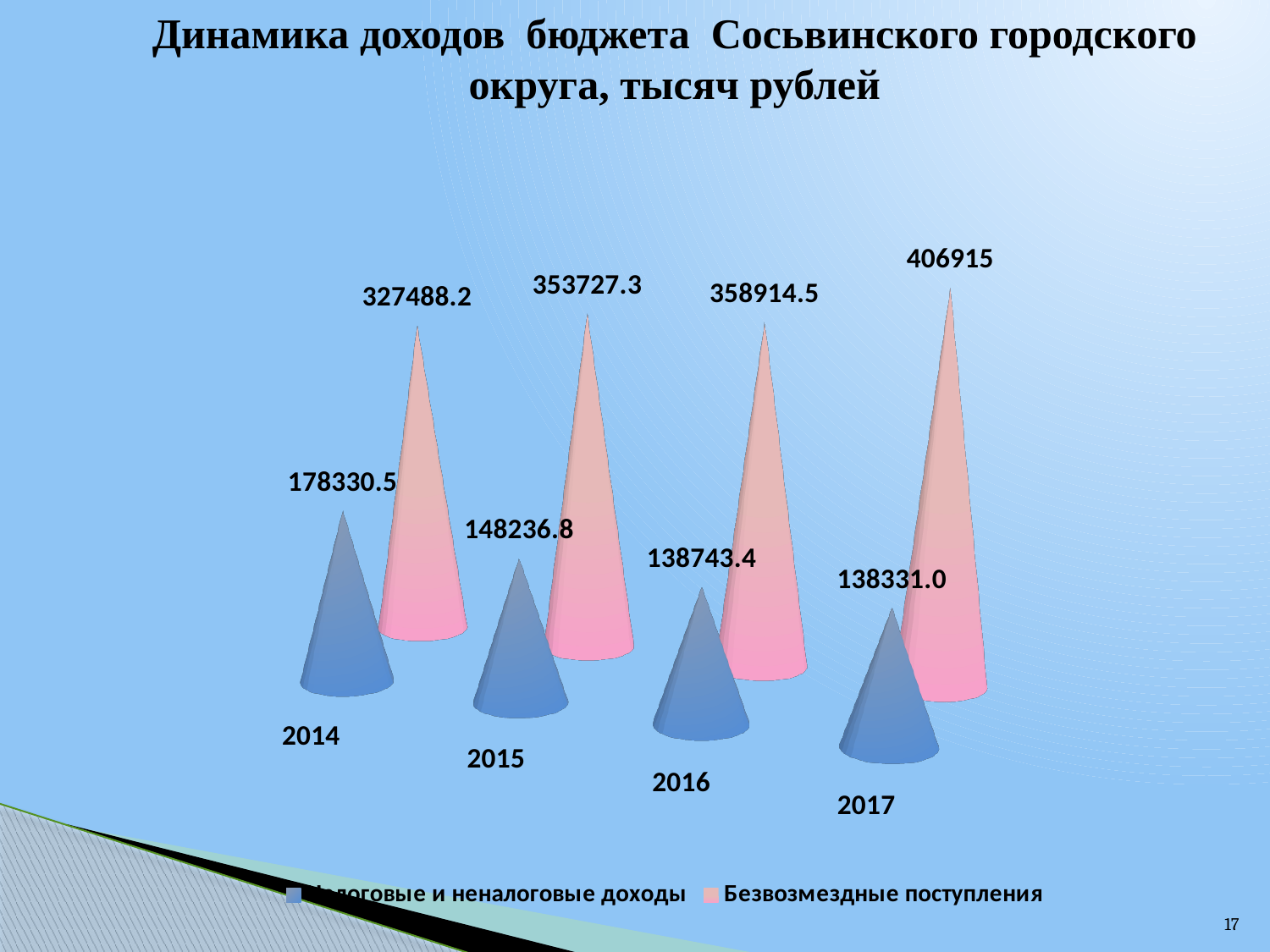
What is the value of Безвозмездные поступления for 2017? 406915 Do the values of Безвозмездные поступления rise or fall from 2014 to 2017? Rise In which year is the blue series (Налоговые и неналоговые доходы) highest? 2014 What kind of chart is shown on the slide? Bar chart What is the value of the blue series (Налоговые и неналоговые доходы) for 2014? 178330.5 In 2016, which is larger: Налоговые и неналоговые доходы or Безвозмездные поступления? Безвозмездные поступления In which year is Безвозмездные поступления highest? 2017 What is the value of Безвозмездные поступления for 2015? 353727.3 What is the difference between Безвозмездные поступления in 2017 and in 2014? 79426.8 How many series does the legend list? 2 In which year is Безвозмездные поступления lowest? 2014 How many years are shown on the x axis? 4